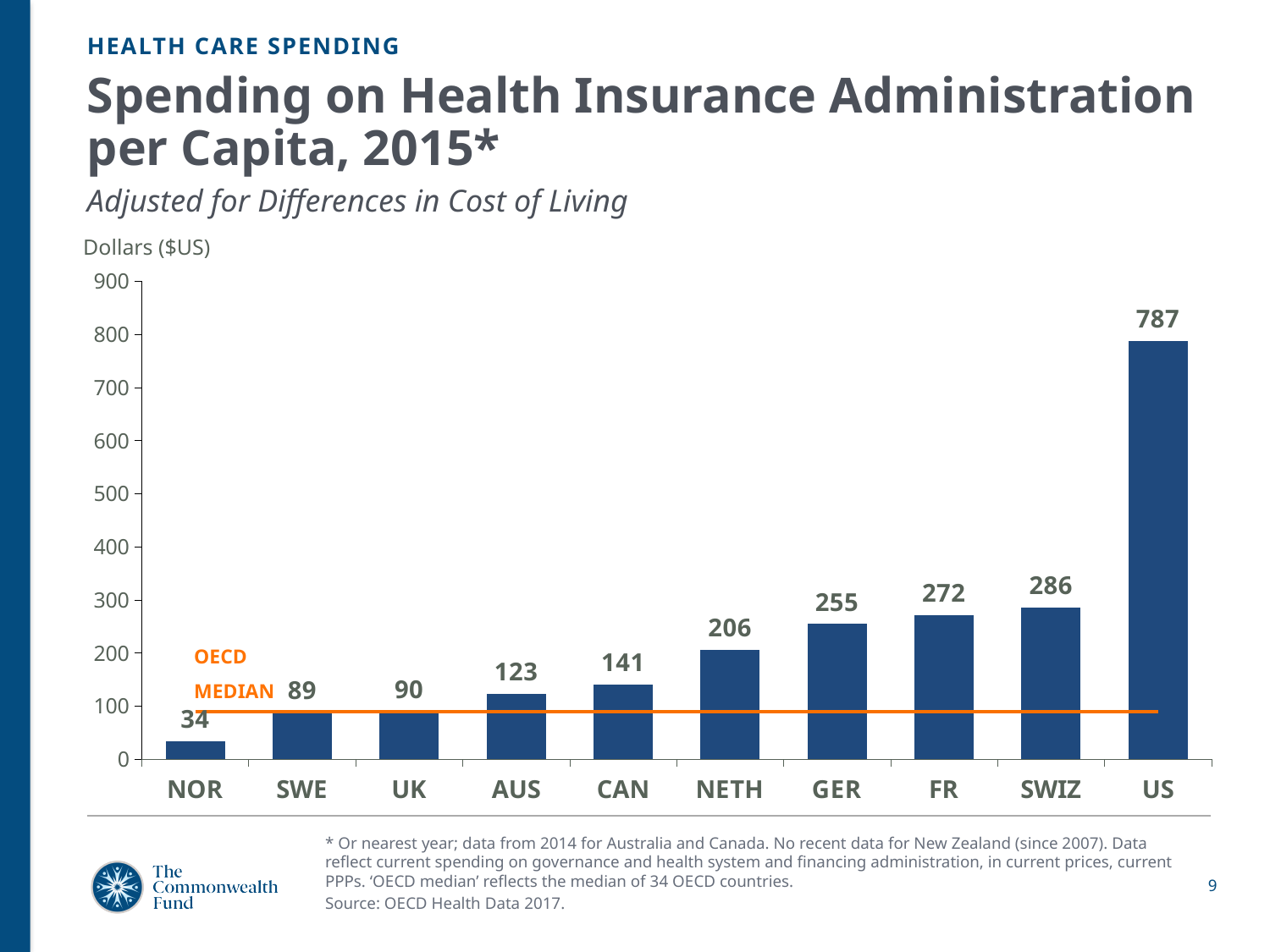
How many countries are shown on the chart? 10 What is the difference between the values for SWIZ and FR? 14 Which country has the lowest spending on health insurance administration per capita? NOR What is the value for NOR? 34 Is the OECD median line greater or less than 100? less What is the value for NETH? 206 What is the value for the US? 787 What does the orange horizontal line on the chart represent? OECD median What kind of chart is shown on the slide? bar chart What is the difference between the values for the US and GER? 532 Which country has the highest spending on health insurance administration per capita? US Which is larger, the value for CAN or the value for AUS? CAN